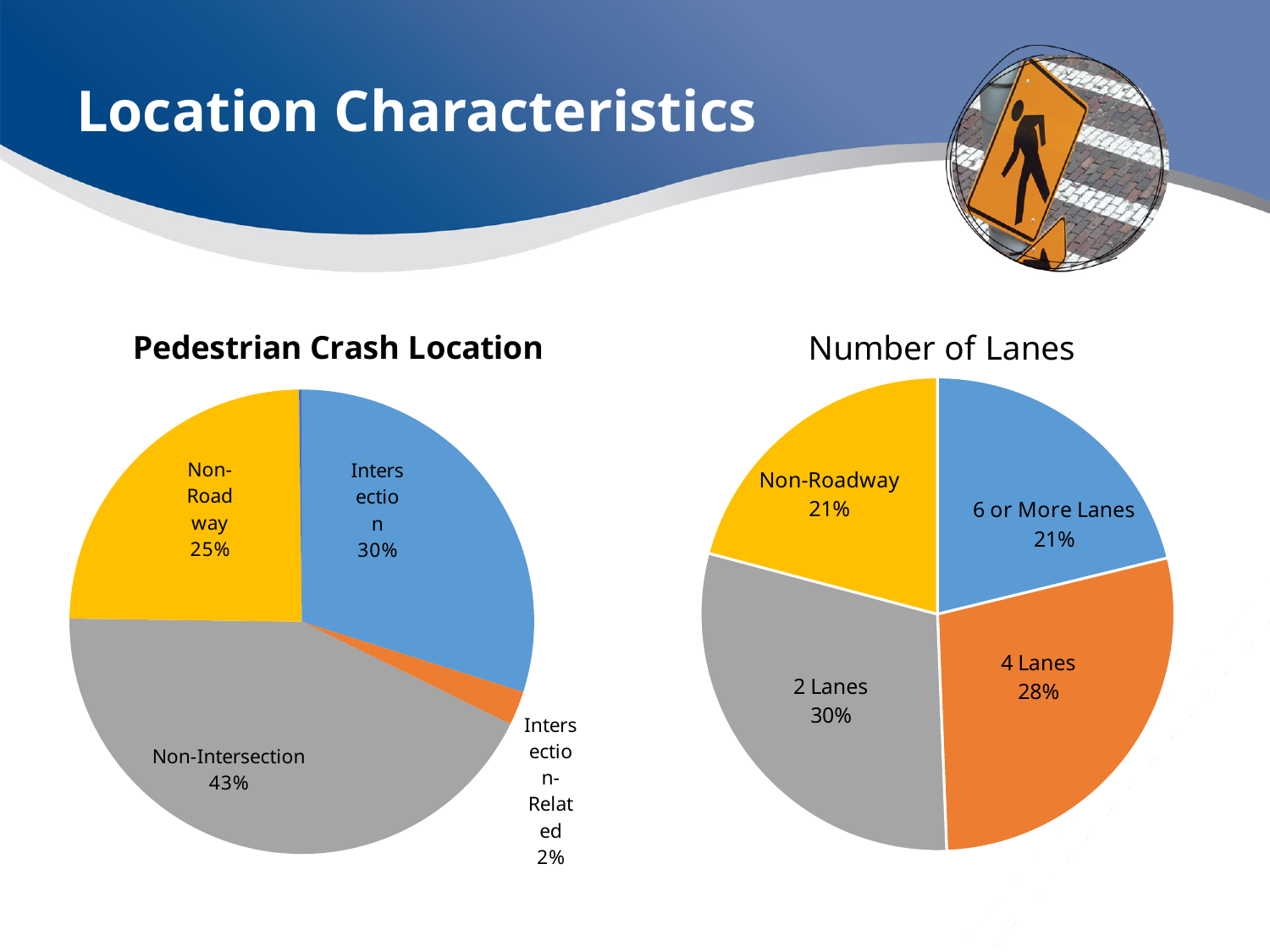
In the Number of Lanes chart, what share is 4 Lanes? 28% What type of chart is the Number of Lanes chart? Pie chart In the Pedestrian Crash Location chart, what is the difference between the Non-Intersection and Intersection shares? 13% In the Number of Lanes chart, what colour is the 2 Lanes slice? Gray In the Pedestrian Crash Location chart, what share of crashes occurred at Non-Intersection locations? 43% In the Number of Lanes chart, what share is Non-Roadway? 21% In the Number of Lanes chart, which category has the largest share? 2 Lanes In the Pedestrian Crash Location chart, which category has the largest share? Non-Intersection In the Pedestrian Crash Location chart, how many slices does the pie have? 4 In the Pedestrian Crash Location chart, which category has the smallest share? Intersection-Related In the Pedestrian Crash Location chart, what share of crashes were Intersection-Related? 2% In the Number of Lanes chart, which is larger, 4 Lanes or 6 or More Lanes? 4 Lanes